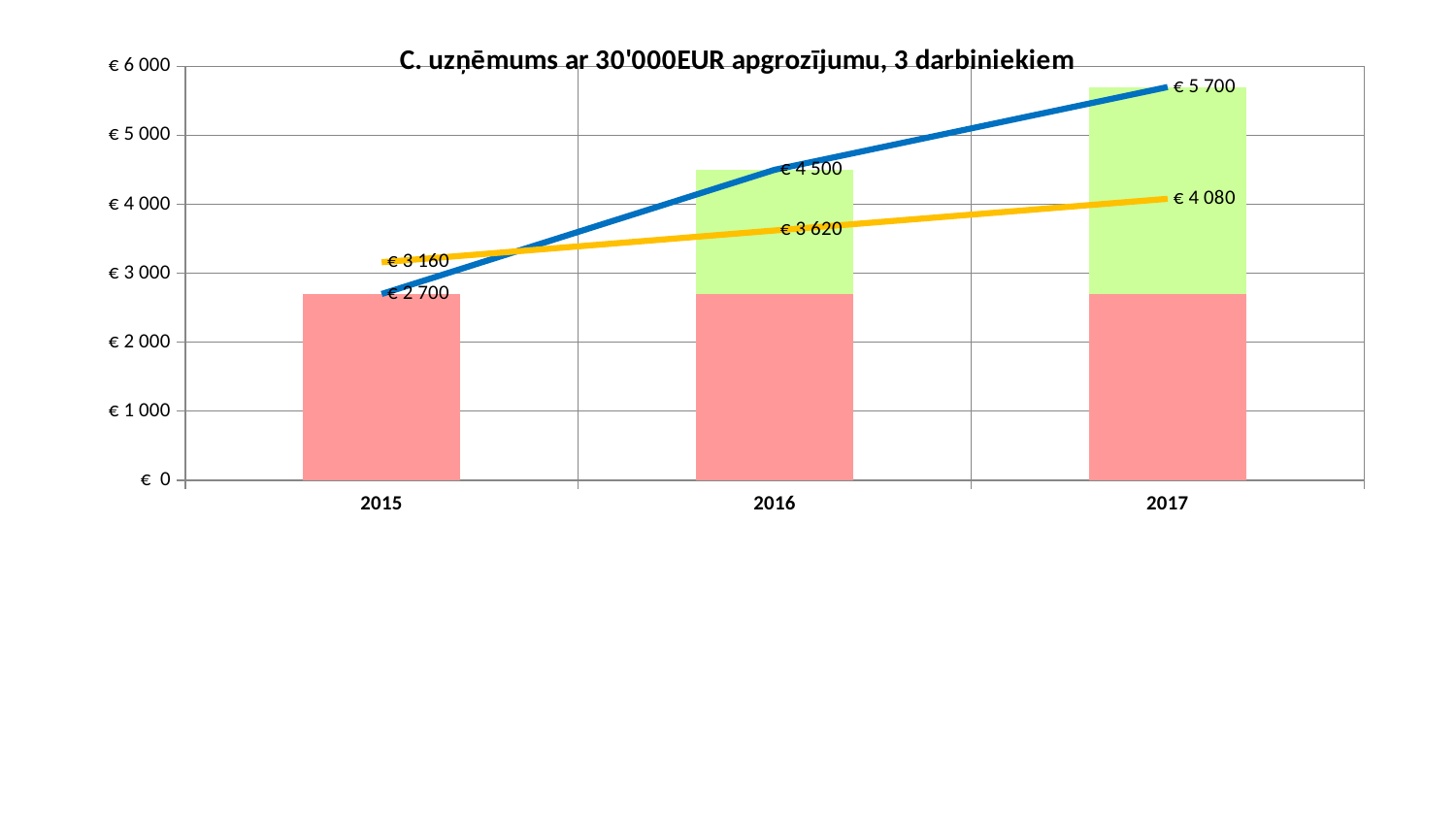
How many years are shown on the x axis? 3 What is the value labelled on the yellow line for 2016? € 3 620 In which year does the blue line reach its highest labelled value? 2017 What is the value labelled on the yellow line for 2015? € 3 160 Does the blue line rise or fall from 2015 to 2017? rise What is the value labelled on the blue line for 2015? € 2 700 What is the difference between the yellow line's 2017 value and its 2016 value? € 460 In 2015, which line has the larger labelled value, the blue line or the yellow line? the yellow line What is the difference between the blue line's 2017 value and its 2015 value? € 3 000 What is the value labelled on the blue line for 2017? € 5 700 Is the height of the red bar segment for 2016 greater or less than € 3 000? less In which year does the yellow line have its lowest labelled value? 2015